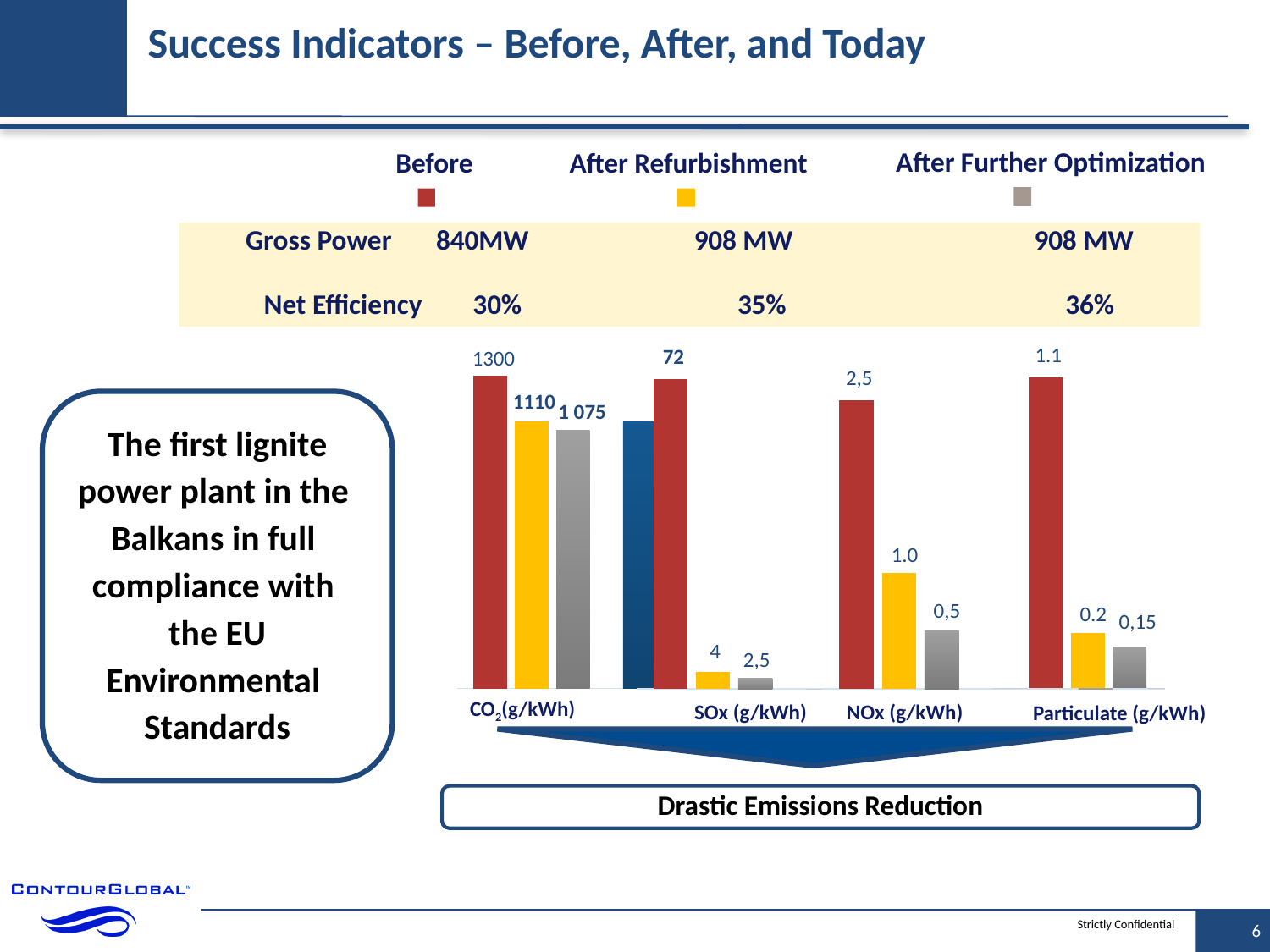
How many emission categories are shown on the x axis of the chart? 4 What is the After Further Optimization value for CO2 (g/kWh)? 1 075 What is the After Refurbishment value for SOx (g/kWh)? 4 Which is larger for SOx (g/kWh): the Before value or the After Refurbishment value? Before Which colour represents the After Refurbishment series in the chart? Yellow What is the Before value for Particulate (g/kWh)? 1.1 How many series (Before, After Refurbishment, After Further Optimization) are plotted in the chart? 3 What is the After Further Optimization value for NOx (g/kWh)? 0,5 Which category has the highest Before value? CO2 (g/kWh) What kind of chart is shown on the slide? Bar chart What is the Before value for CO2 (g/kWh)? 1300 What is the difference between the Before and After Refurbishment values for CO2 (g/kWh)? 190